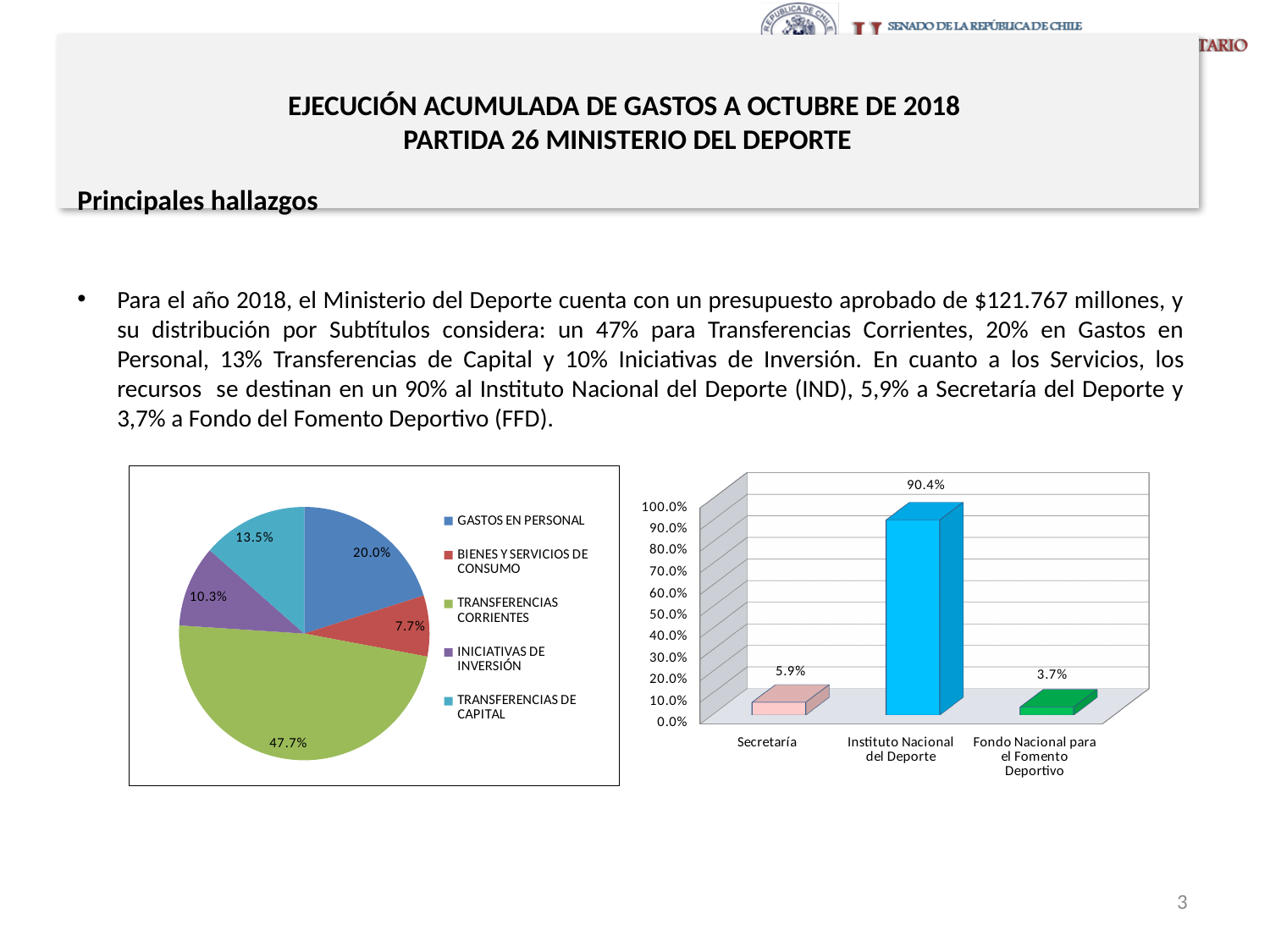
In the bar chart on the right, which category has the lowest value? Fondo Nacional para el Fomento Deportivo In the pie chart on the left, what share is labelled for GASTOS EN PERSONAL? 20.0% How many categories are shown on the x axis of the bar chart on the right? 3 In the bar chart on the right, what is the difference between the values for Instituto Nacional del Deporte and Secretaría? 84.5% In the pie chart on the left, which category has the smallest slice? BIENES Y SERVICIOS DE CONSUMO In the pie chart on the left, what is the difference between the shares for TRANSFERENCIAS DE CAPITAL and INICIATIVAS DE INVERSIÓN? 3.2% In the pie chart on the left, what share is labelled for TRANSFERENCIAS CORRIENTES? 47.7% In the bar chart on the right, what is the value for Instituto Nacional del Deporte? 90.4% In the bar chart on the right, what is the value for Secretaría? 5.9% In the pie chart on the left, which category has the largest slice? TRANSFERENCIAS CORRIENTES How many categories does the legend of the pie chart on the left list? 5 What kind of chart is the chart on the right of the slide? Bar chart